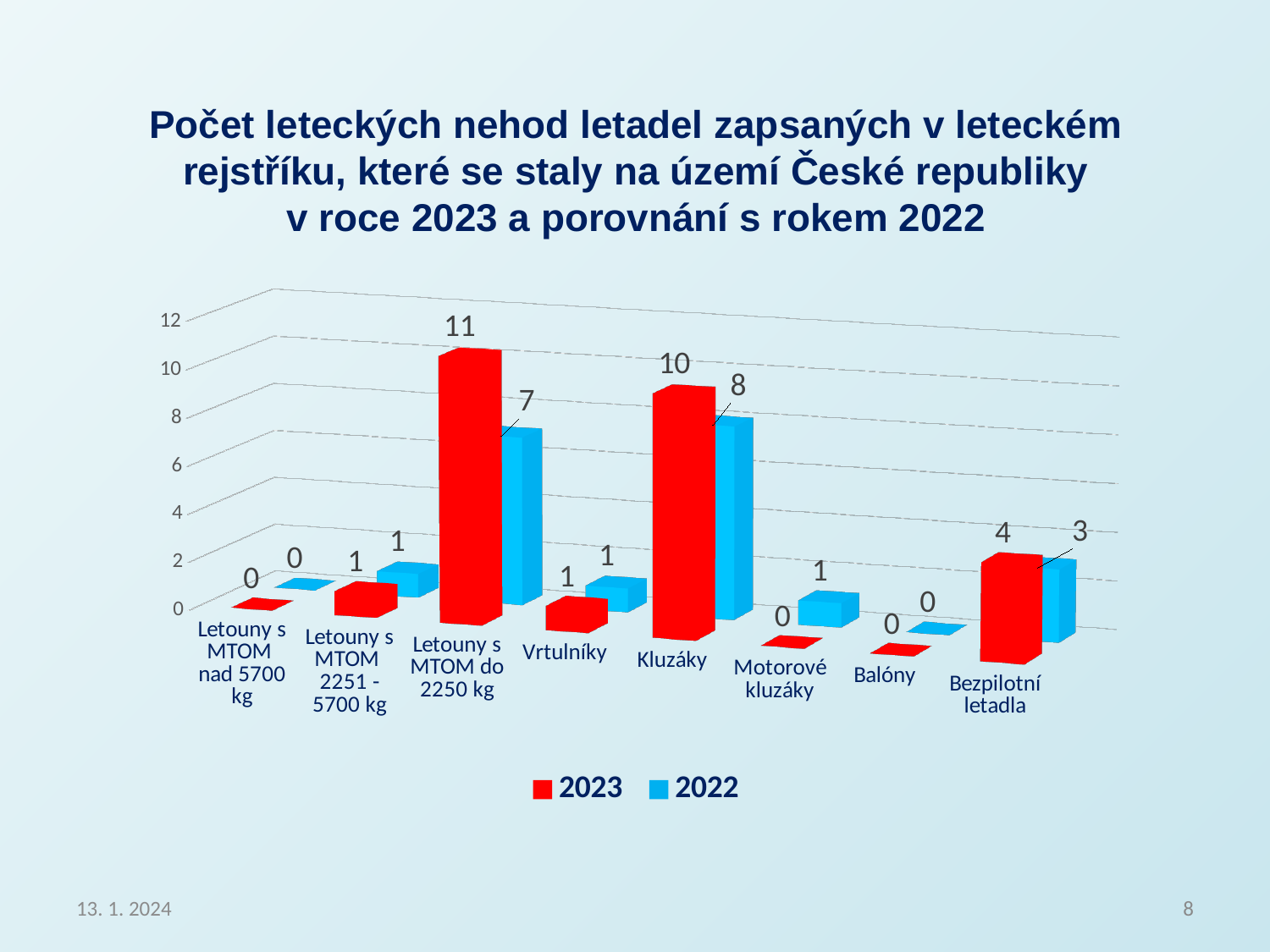
What is the 2022 value for Kluzáky? 8 What kind of chart is shown on the slide? bar chart What is the difference between the 2023 and 2022 values for Kluzáky? 2 What is the 2023 value for Bezpilotní letadla? 4 Which is larger for Bezpilotní letadla, the 2023 value or the 2022 value? 2023 How many series does the legend list? 2 Which category has the highest 2022 value? Kluzáky What is the 2022 value for Motorové kluzáky? 1 What is the difference between the 2023 and 2022 values for Letouny s MTOM do 2250 kg? 4 How many categories are shown on the x axis? 8 What is the 2023 value for Letouny s MTOM do 2250 kg? 11 Which category has the highest 2023 value? Letouny s MTOM do 2250 kg